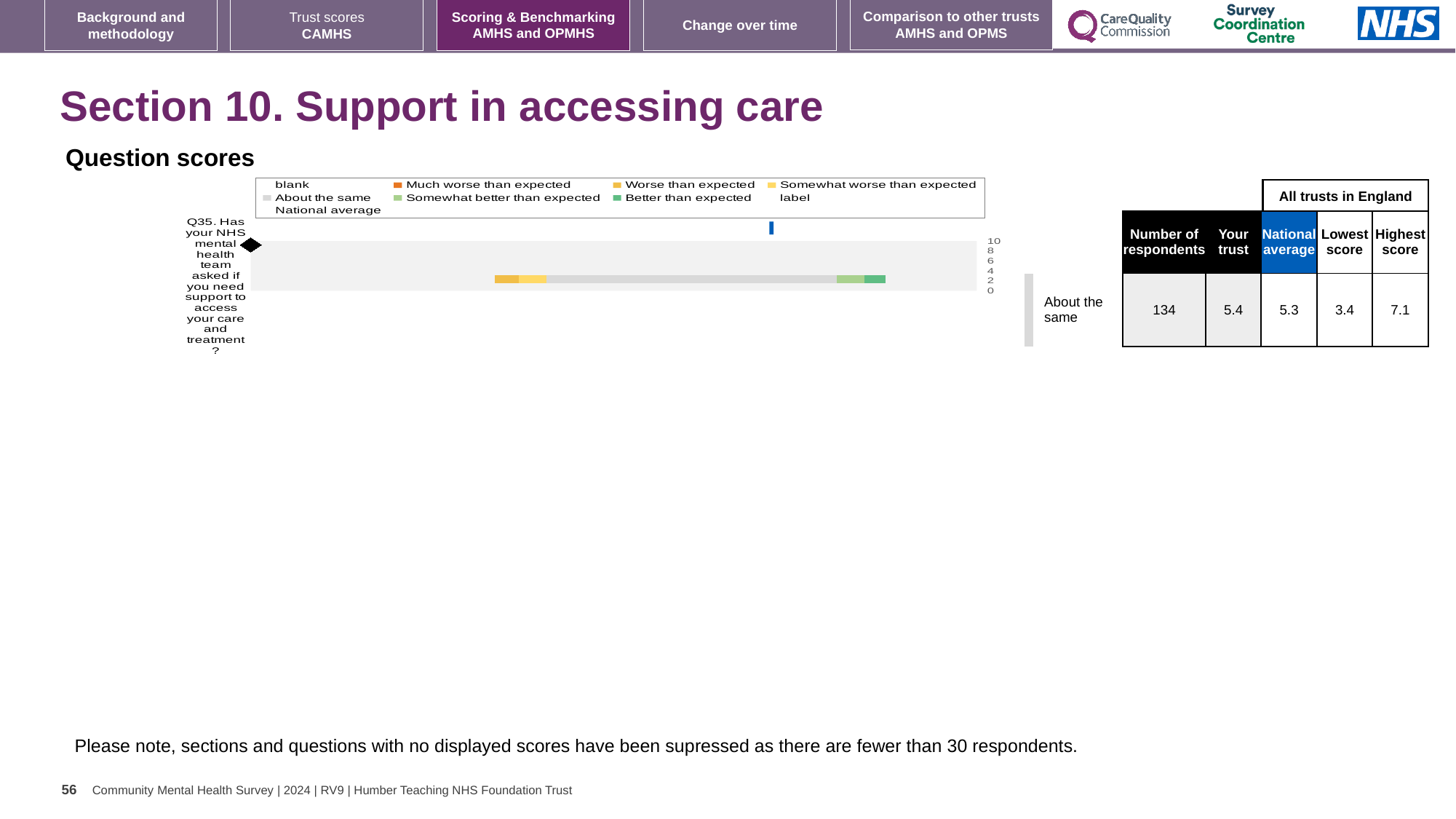
For Q35, what is the difference between the highest score and the lowest score among all trusts in England? 3.7 According to the table beside the chart, what is the highest score among all trusts in England for Q35? 7.1 According to the table beside the chart, what is the national average score for Q35? 5.3 According to the table beside the chart, what is the number of respondents for Q35? 134 How many questions (categories) are plotted in the Question scores chart? 1 How many entries does the legend of the Question scores chart list? 9 Which question is plotted in the Question scores chart? Q35. Has your NHS mental health team asked if you need support to access your care and treatment? What kind of chart is shown under "Question scores"? bar chart According to the table beside the chart, what is the lowest score among all trusts in England for Q35? 3.4 For Q35, which is larger: the "Your trust" score or the national average? Your trust According to the table beside the chart, what is the "Your trust" score for Q35? 5.4 What benchmark category label is shown to the right of the Q35 bar? About the same